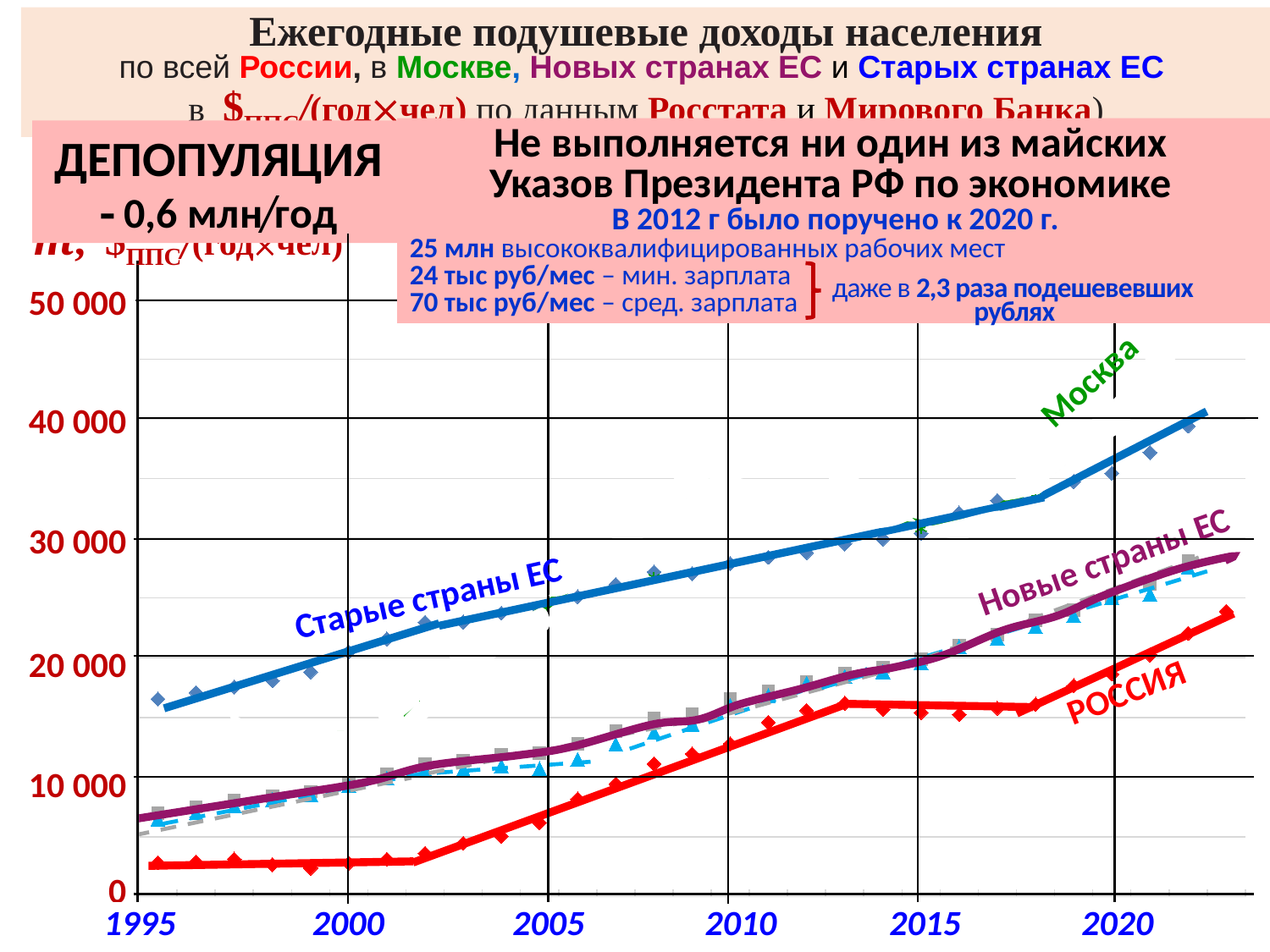
Do the values for Россия rise or fall overall from 1995 to the end of the series? rise Is the value for Новые страны ЕС in 2020 greater or less than 20 000? greater Is the value for Старые страны ЕС in 2005 greater or less than 20 000? greater Is the value for Россия in 2020 greater or less than 20 000? less What kind of chart is shown on the slide? line chart Which series has the lowest value in 2020? Россия In 2010, which is larger: the value for Старые страны ЕС or the value for Россия? Старые страны ЕС What is the highest tick value shown on the vertical axis? 50 000 How many series (regions) does the chart title list? 4